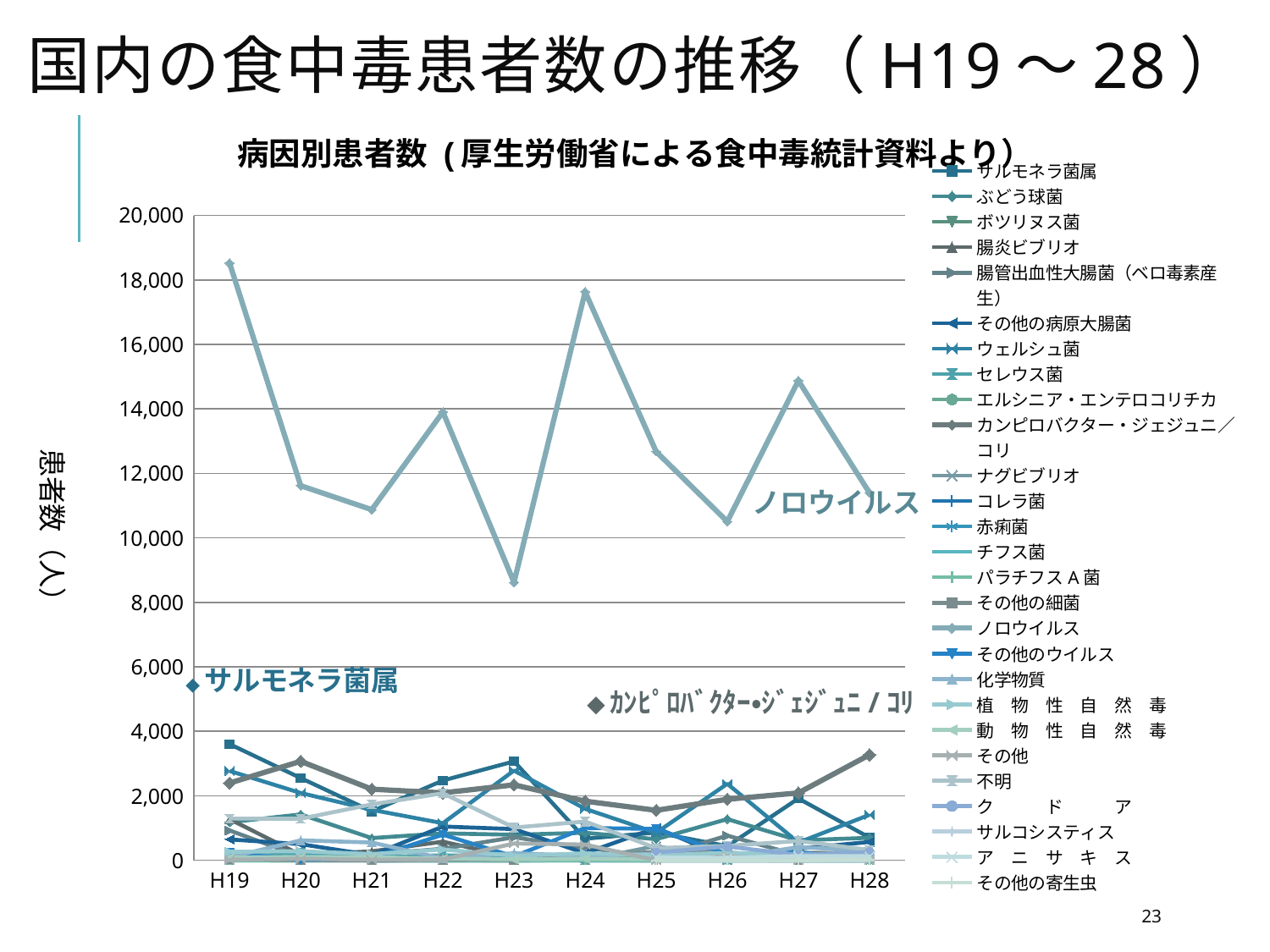
In which year does the ノロウイルス series reach its lowest value? H23 Is the value for ノロウイルス in H24 greater or less than 16,000? greater Is the value for ノロウイルス in H23 greater or less than 10,000? less How many series does the legend list? 27 What kind of chart is shown on the slide? line chart Which is larger for ノロウイルス: the value in H24 or the value in H25? H24 What is the title of the chart? 病因別患者数（厚生労働省による食中毒統計資料より） How many years (x-axis categories) are plotted on the chart? 10 In which year does the ノロウイルス series reach its highest value? H19 Does the ノロウイルス series rise or fall from H19 to H20? fall Is the value for ノロウイルス in H19 greater or less than 18,000? greater What is the label on the vertical axis? 患者数（人）